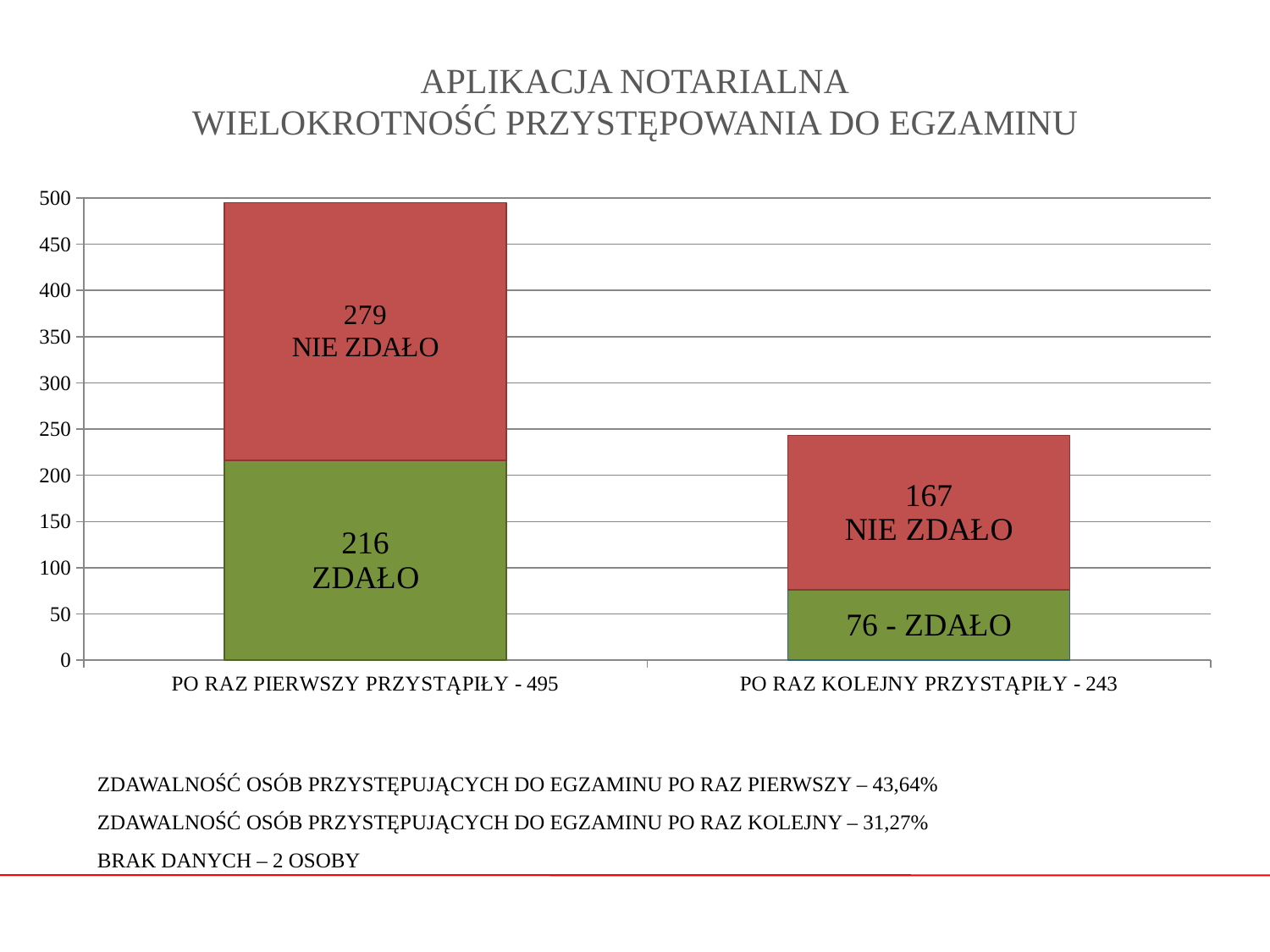
How many people failed (NIE ZDAŁO) among those who took the exam again (PO RAZ KOLEJNY PRZYSTĄPIŁY)? 167 What is the total of the stacked bar for PO RAZ KOLEJNY PRZYSTĄPIŁY? 243 What is the difference between the number who failed and the number who passed among first-time takers (PO RAZ PIERWSZY PRZYSTĄPIŁY)? 63 How many people failed (NIE ZDAŁO) among those who took the exam for the first time (PO RAZ PIERWSZY PRZYSTĄPIŁY)? 279 How many people passed (ZDAŁO) among those who took the exam for the first time (PO RAZ PIERWSZY PRZYSTĄPIŁY)? 216 How many people passed (ZDAŁO) among those who took the exam again (PO RAZ KOLEJNY PRZYSTĄPIŁY)? 76 Which colour represents the NIE ZDAŁO (failed) segment in the chart? Red What is the total of the stacked bar for PO RAZ PIERWSZY PRZYSTĄPIŁY? 495 Is the total for PO RAZ KOLEJNY PRZYSTĄPIŁY greater or less than 250? less What type of chart is shown on the slide? Stacked bar chart Which category has the higher total bar, PO RAZ PIERWSZY PRZYSTĄPIŁY or PO RAZ KOLEJNY PRZYSTĄPIŁY? PO RAZ PIERWSZY PRZYSTĄPIŁY How many categories are shown on the x axis of the chart? 2